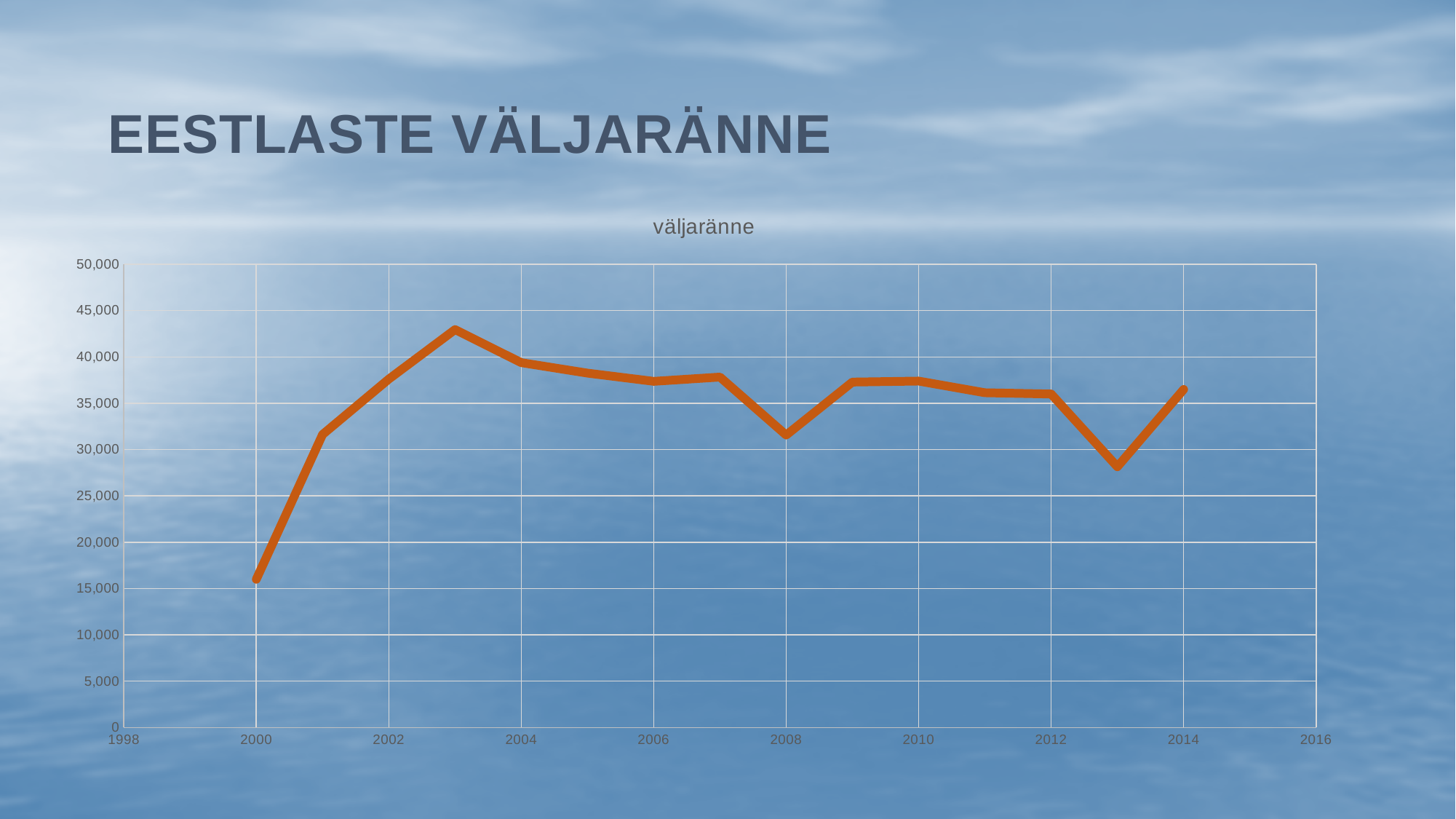
Is the value for 2000 greater or less than 20,000? less What kind of chart is shown on the slide? line chart How many data points are plotted on the line? 15 Is the value for 2003 greater or less than 40,000? greater Does the line rise or fall between 2000 and 2003? rise Is the value for 2008 greater or less than 30,000? greater In which year does the line reach its highest value? 2003 In which year does the line have its lowest value? 2000 Which year has the larger value, 2003 or 2008? 2003 What is the title of the chart? väljaränne Which year has the larger value, 2000 or 2013? 2013